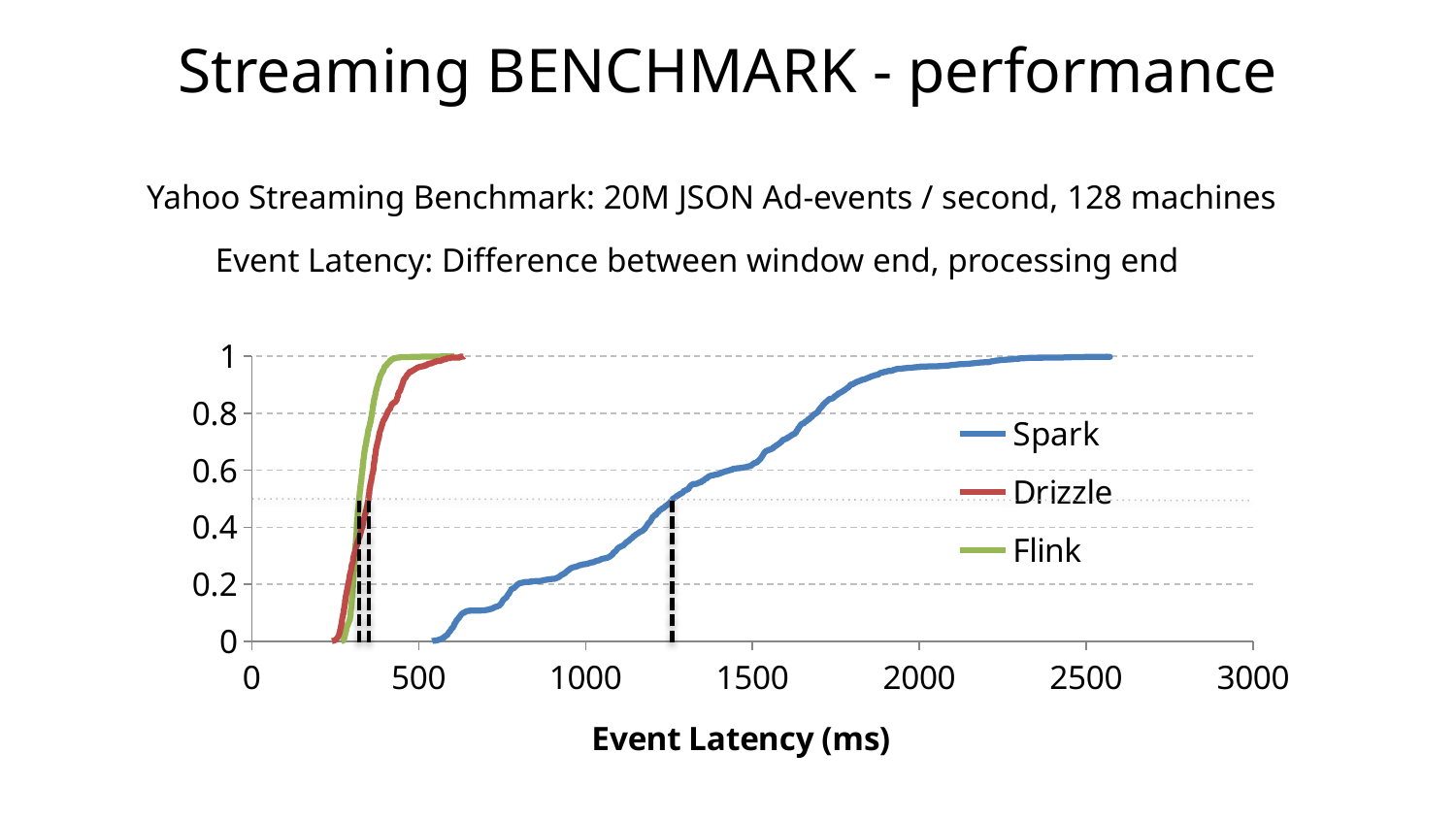
Which series reaches a value of 1 at the lowest event latency? Flink Is the event latency at which the Spark curve reaches 1 greater or less than 2000? greater Is the event latency at which the Spark curve reaches 0.5 greater or less than 1000? greater Is the event latency at which the Spark curve starts rising above 0 greater or less than 500? greater Which series reaches 0.5 at a lower event latency, Spark or Drizzle? Drizzle What kind of chart is shown on the slide? line chart Do the plotted values rise or fall as event latency increases along the x axis? rise How many series does the legend list? 3 Which series reaches a value of 1 at the highest event latency? Spark What is the title of the x axis? Event Latency (ms) Which series are listed in the legend? Spark, Drizzle, Flink